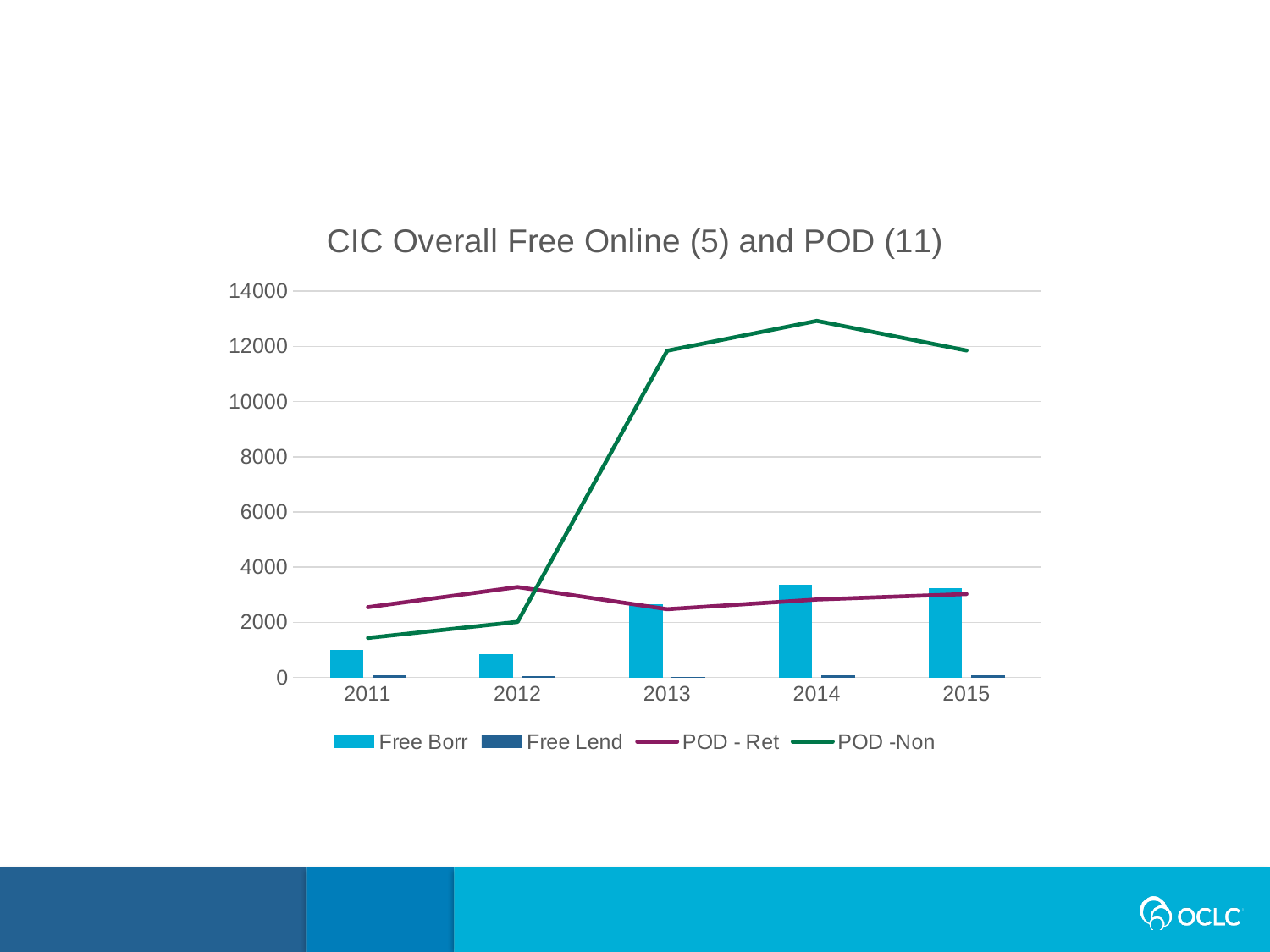
In which year is the POD -Non line at its lowest value? 2011 In which year does the POD - Ret line reach its highest value? 2012 What is the title of the chart? CIC Overall Free Online (5) and POD (11) Is the value for Free Borr in 2013 greater or less than 2000? greater Is the value for POD -Non in 2014 greater or less than 12000? greater Does the POD -Non line rise or fall from 2011 to 2014? rise How many series does the legend list? 4 How many years are shown on the x axis? 5 What kind of chart is this? A combined bar and line chart In 2013, which is larger: POD -Non or POD - Ret? POD -Non Is the value for POD -Non in 2012 greater or less than 4000? less In which year does the POD -Non line reach its highest value? 2014